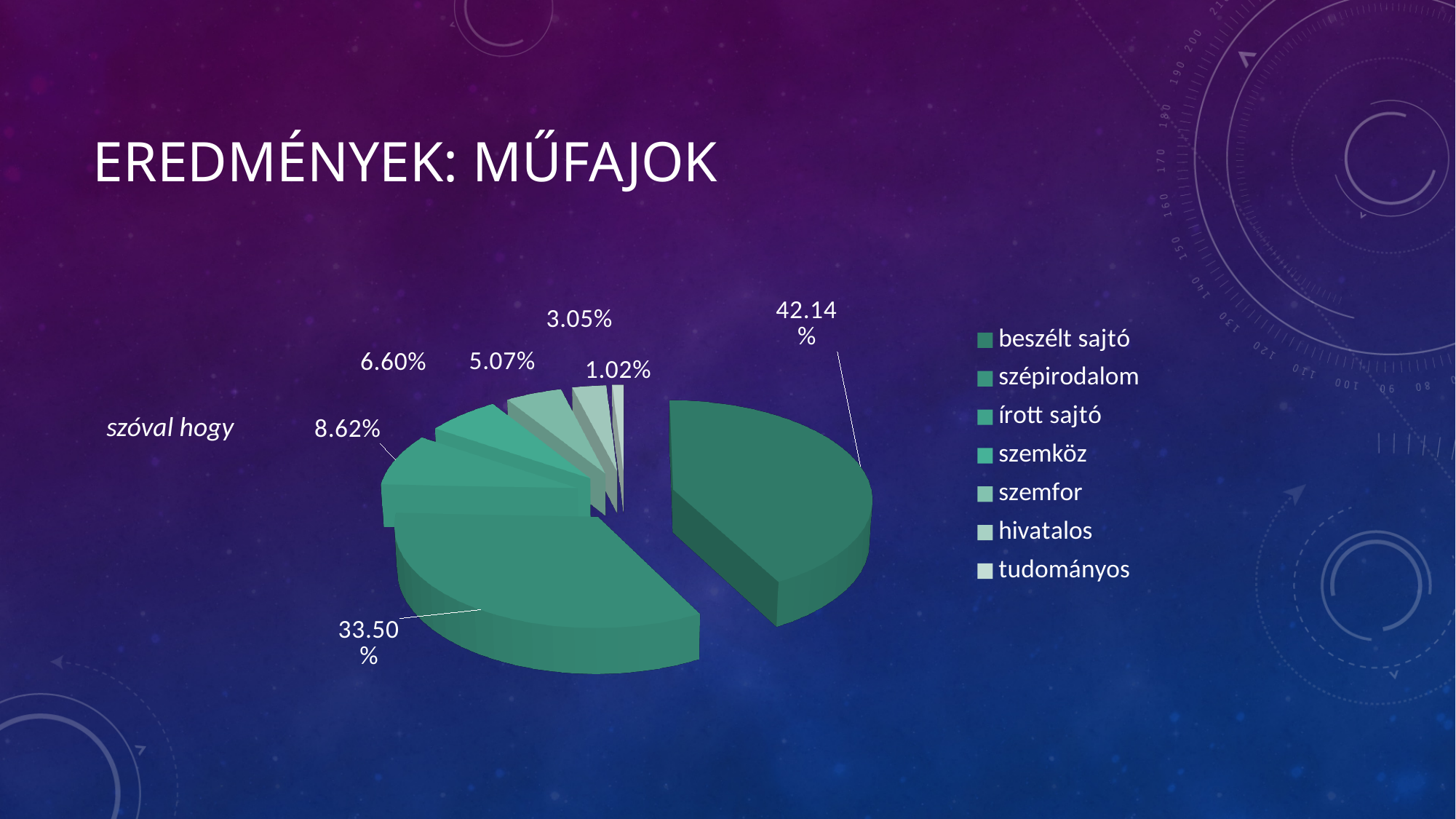
Which category has the largest slice of the pie? beszélt sajtó What is the title of the slide containing the pie chart? EREDMÉNYEK: MŰFAJOK What share of the pie does szépirodalom have? 33.50% What share of the pie does beszélt sajtó have? 42.14% What is the combined share of hivatalos and tudományos? 4.07% Which category has the smallest slice of the pie? tudományos What share of the pie does írott sajtó have? 8.62% How many categories does the legend of the pie chart list? 7 Which is larger, the share for szemköz or the share for szemfor? szemköz What kind of chart is shown on the slide? pie chart What share of the pie does tudományos have? 1.02% What is the difference in percentage points between beszélt sajtó and szépirodalom? 8.64